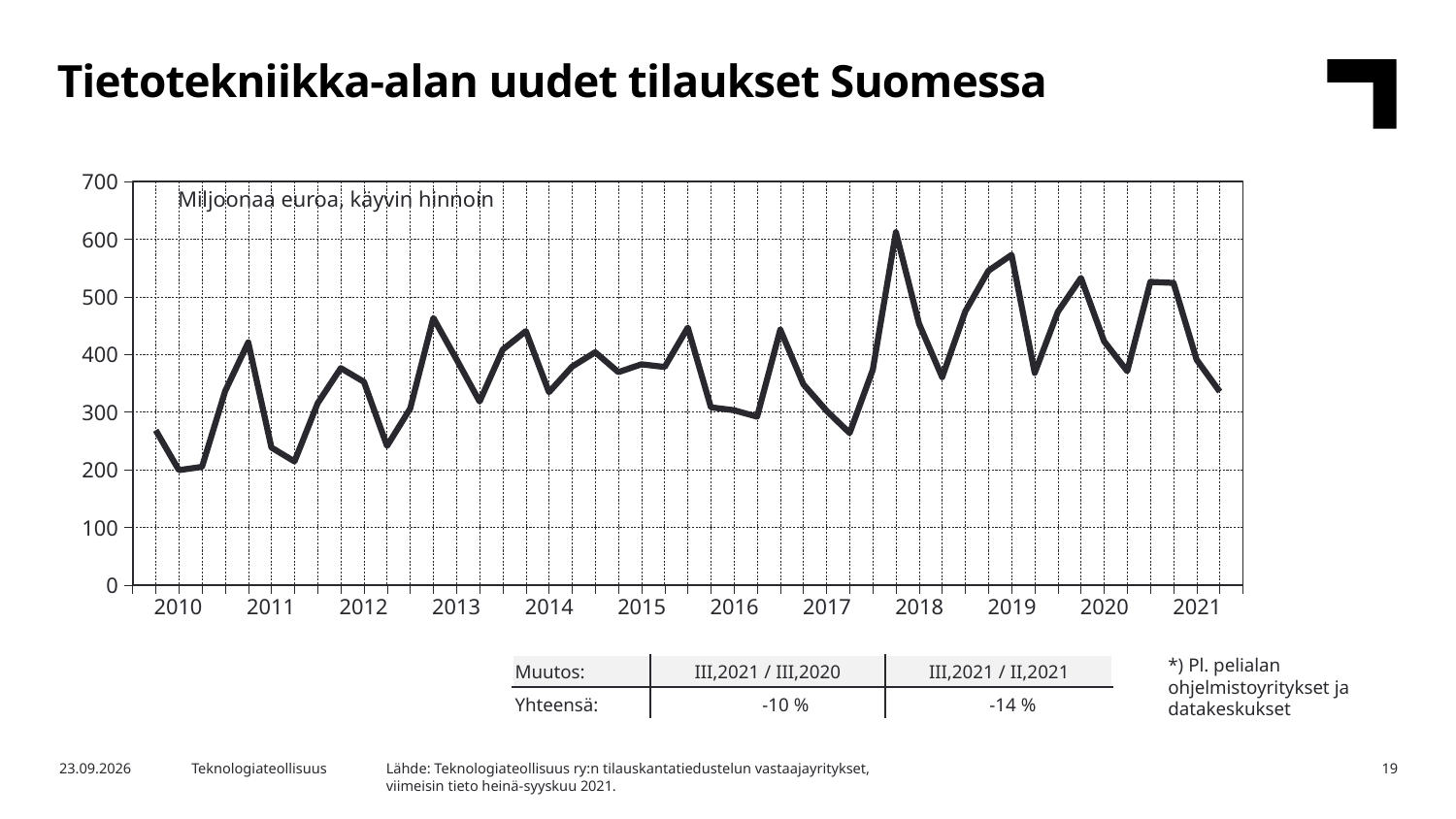
According to the table below the chart, what is the change for III,2021 / II,2021? -14 % Is the last plotted value in 2021 greater or less than 400? less What unit is stated inside the chart area? Miljoonaa euroa, käyvin hinnoin According to the table below the chart, what is the change for III,2021 / III,2020? -10 % Does the line rise or fall from its 2019 peak to the end of 2021? fall How many year labels are shown on the x axis? 12 What is the highest value shown on the y axis? 700 Is the first plotted value at the start of 2010 greater or less than 300? less What is the title of the slide's chart? Tietotekniikka-alan uudet tilaukset Suomessa Is the lowest value on the line greater or less than 300? less What kind of chart is shown on the slide? line chart